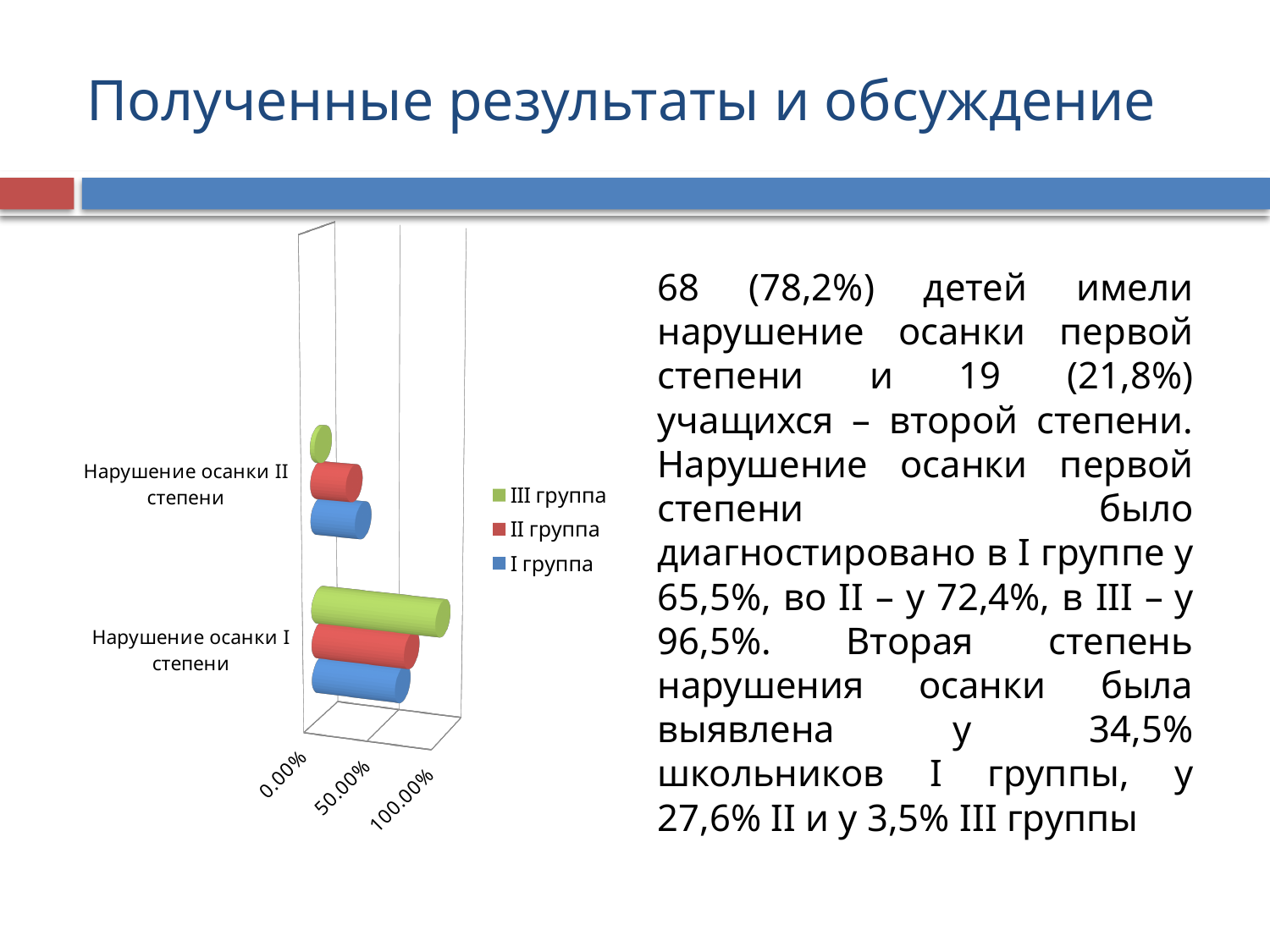
Is the value for II группа in Нарушение осанки I степени greater or less than 50.00%? greater Which group has the shortest bar for Нарушение осанки II степени? III группа For I группа, which category has the larger value: Нарушение осанки I степени or Нарушение осанки II степени? Нарушение осанки I степени What are the three entries listed in the chart legend? III группа, II группа, I группа Is the value for I группа in Нарушение осанки II степени greater or less than 50.00%? less Which group has the longest bar for Нарушение осанки I степени? III группа Which colour represents III группа in the chart legend? green Is the value for III группа in Нарушение осанки I степени greater or less than 50.00%? greater How many categories are shown on the chart's vertical axis? 2 What kind of chart is shown on the slide? bar chart For Нарушение осанки I степени, which is larger: the value for III группа or for I группа? III группа How many series does the chart legend list? 3